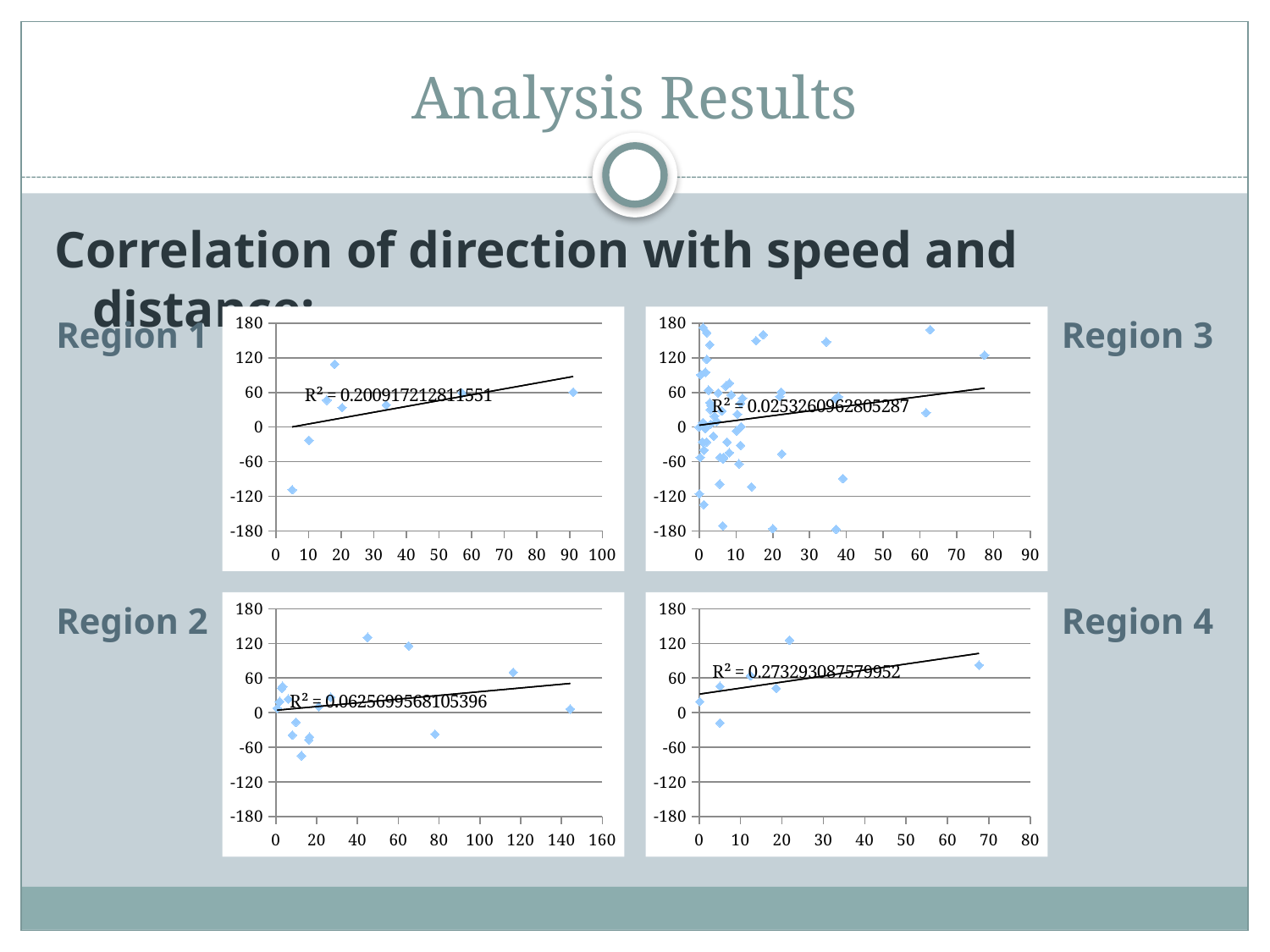
In the Region 1 chart, what R² value is printed? R² = 0.200917212811551 In the Region 4 chart, is the y value of the point near x = 67 greater or less than 60? greater In the Region 2 chart, is the y value of the point near x = 80 greater or less than 0? less In the Region 2 chart, what R² value is printed? R² = 0.0625699568105396 Which region's chart shows the highest R² value? Region 4 In the Region 4 chart, what R² value is printed? R² = 0.273293087579952 In the Region 3 chart, what R² value is printed? R² = 0.0253260962805287 In the Region 4 chart, does the trend line rise or fall as x increases? rise What kind of chart is the Region 1 chart? scatter chart Which region's chart shows the lowest R² value? Region 3 What is the maximum value shown on the x axis of the Region 2 chart? 160 Which has the larger R² value, the Region 1 chart or the Region 2 chart? Region 1